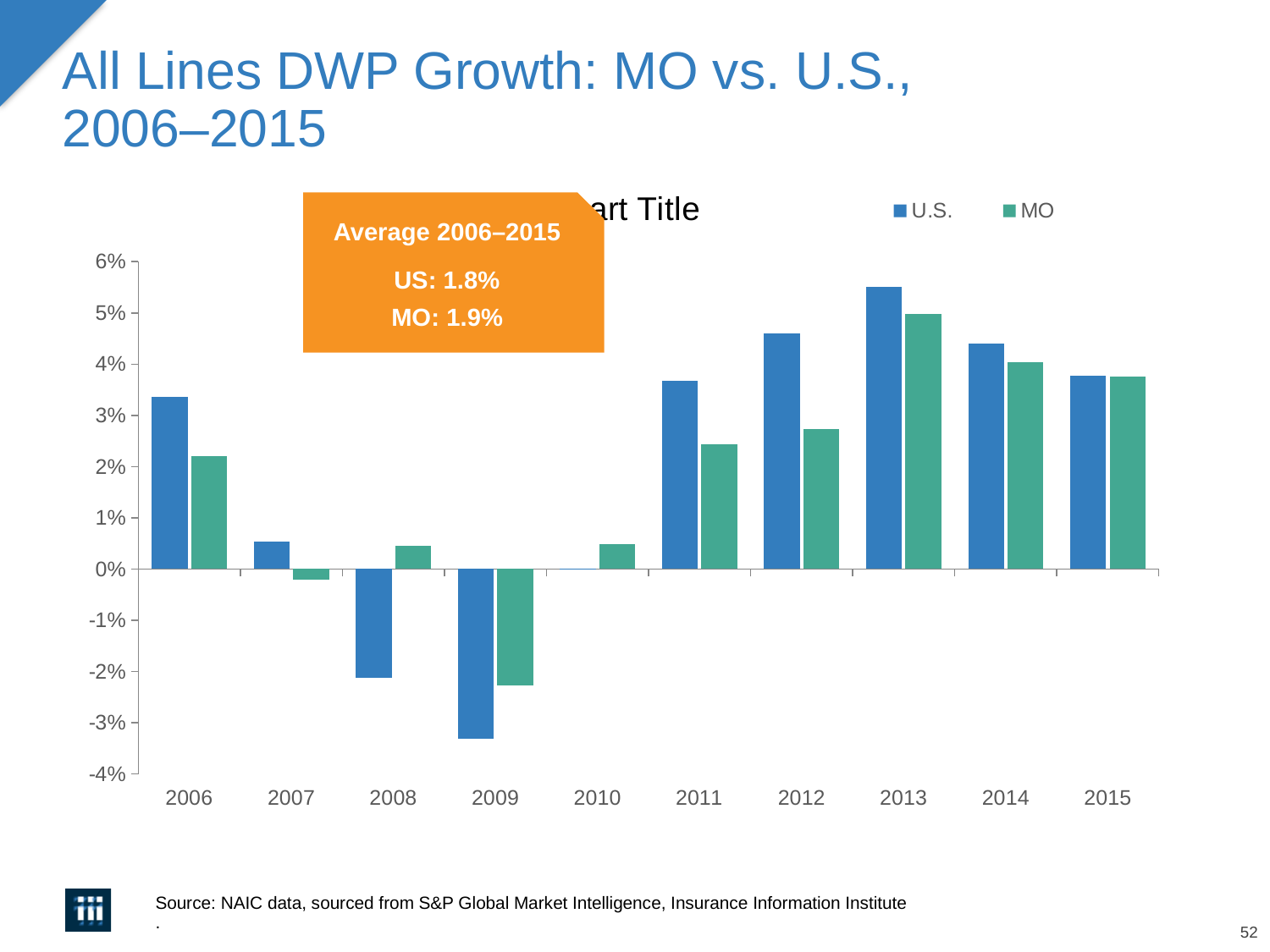
In which year is the MO value highest? 2013 How many series does the legend list? 2 Is the MO value for 2012 greater or less than 3%? less In 2008, which is larger, the U.S. value or the MO value? MO In which year is the U.S. value highest? 2013 How many years are shown on the x axis? 10 What kind of chart is shown on the slide? bar chart According to the callout box, what is the average U.S. DWP growth for 2006–2015? 1.8% In which year is the U.S. value lowest? 2009 In which year is the MO value lowest? 2009 Is the U.S. value for 2009 greater or less than -3%? less Is the U.S. value for 2013 greater or less than 5%? greater